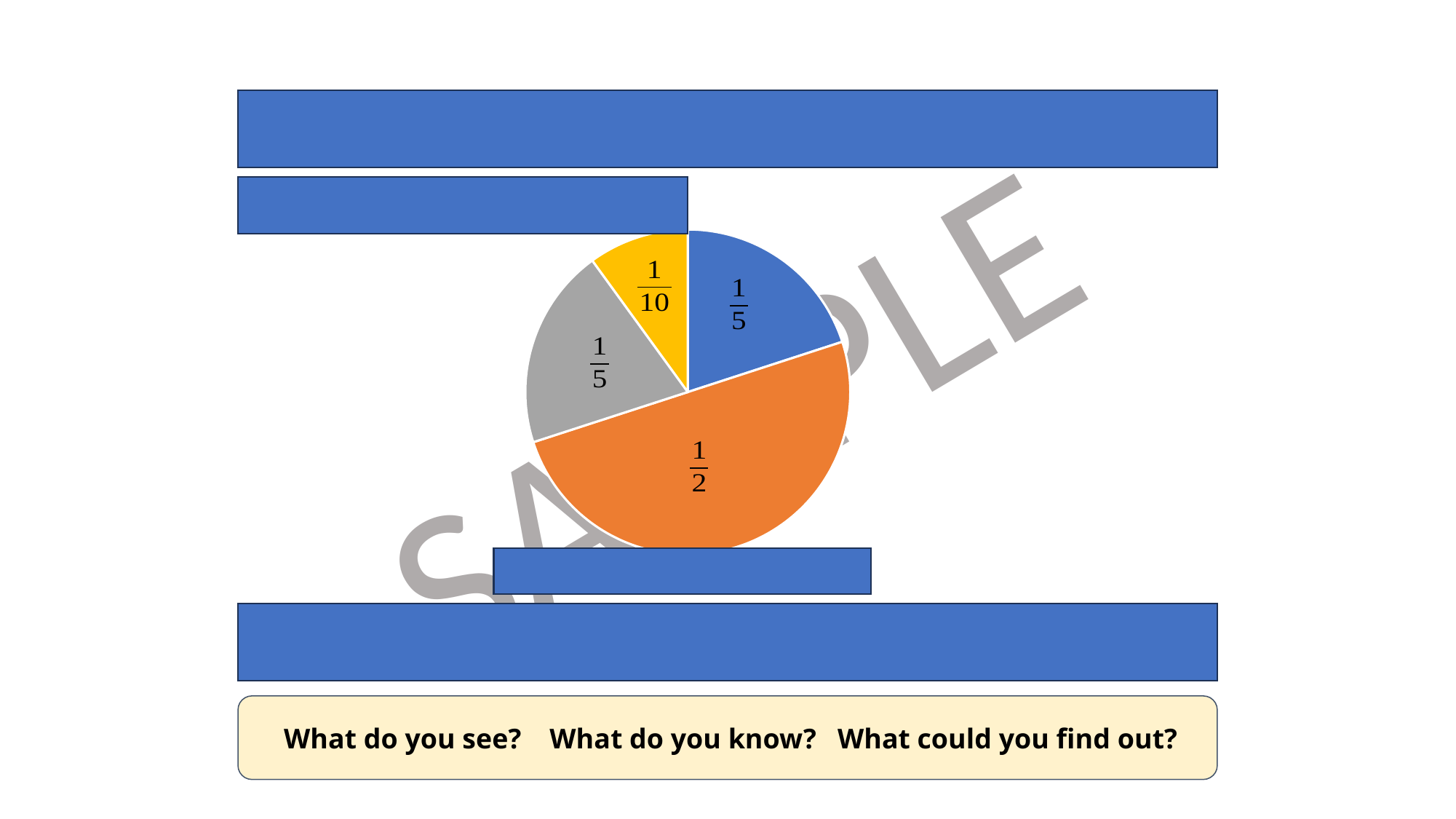
What fraction is printed on the grey slice of the pie chart? 1/5 Which is larger in the pie chart, the orange slice or the blue slice? orange Which colour slice is the smallest in the pie chart? yellow What kind of chart is shown on the slide? pie chart What fraction is printed on the orange slice of the pie chart? 1/2 What fraction is printed on the yellow slice of the pie chart? 1/10 What fraction is printed on the blue slice of the pie chart? 1/5 What share of the whole pie does the orange slice represent? 1/2 How many slices of the pie chart are labelled 1/5? 2 Which is larger in the pie chart, the grey slice or the yellow slice? grey Which colour slice is the largest in the pie chart? orange How many slices does the pie chart have? 4